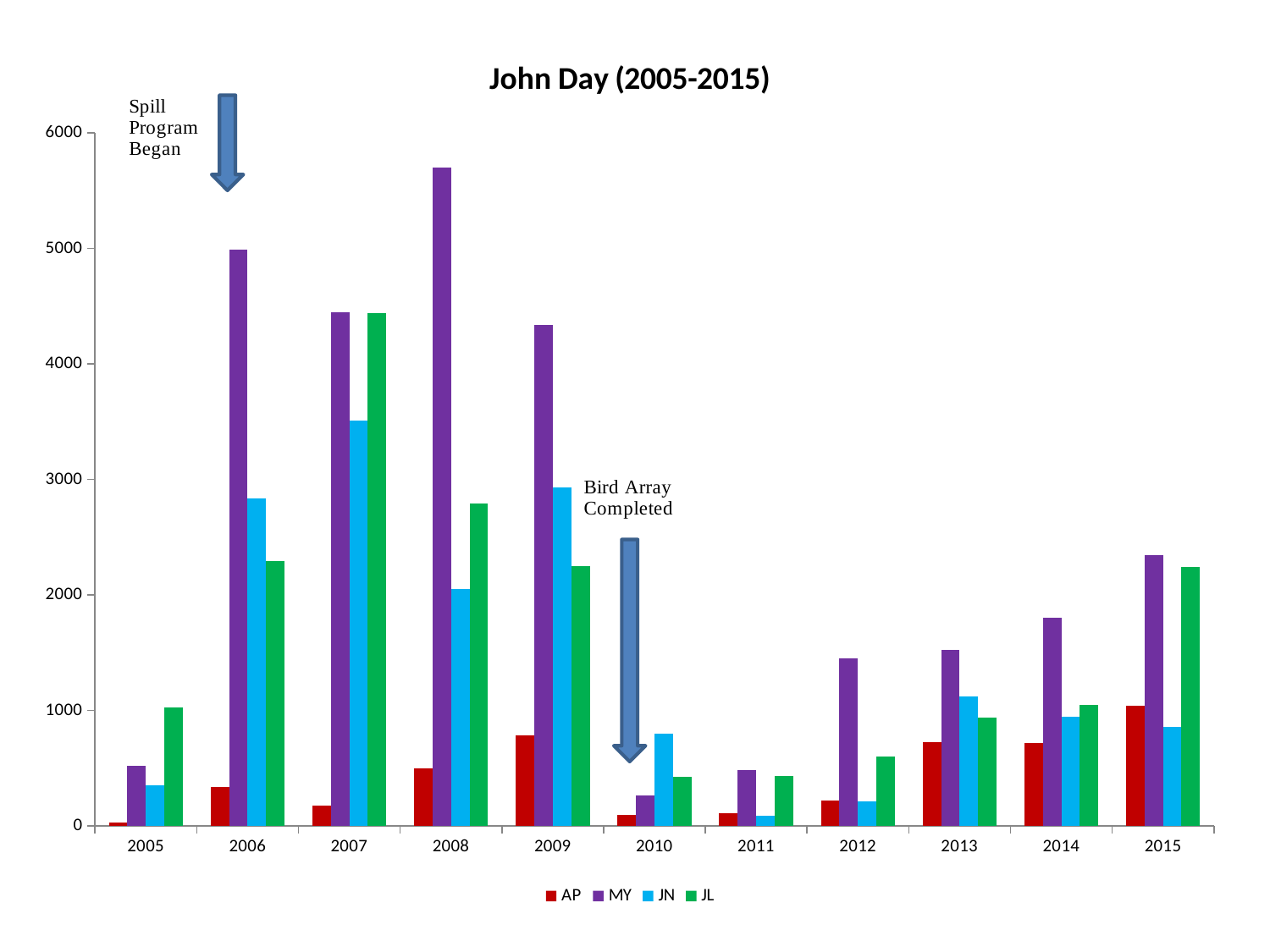
Is the JL value for 2015 greater or less than 2000? greater In which year is the MY bar the lowest? 2010 How many series does the legend list? 4 What is the title of the chart? John Day (2005-2015) In 2006, which is larger, the JN value or the JL value? JN How many years are shown on the x axis? 11 Is the JN value for 2007 greater or less than 3000? greater Is the MY value for 2006 greater or less than 4000? greater What kind of chart is shown on the slide? bar chart Do the MY values rise or fall from 2011 to 2015? rise In which year is the MY bar the highest? 2008